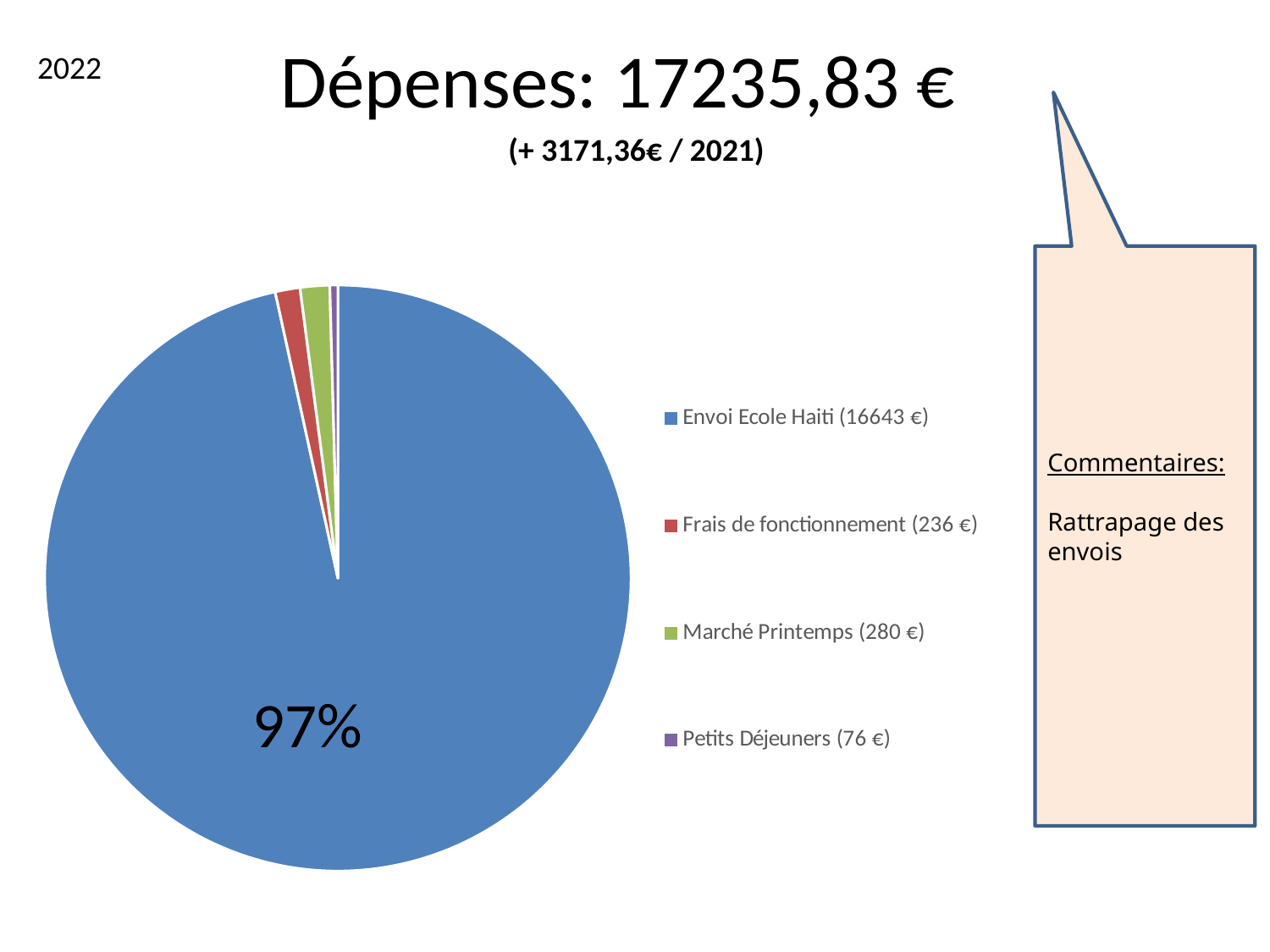
How many categories does the pie chart have? 4 What is the difference between the values for Marché Printemps and Frais de fonctionnement? 44 € Which is larger, Marché Printemps or Frais de fonctionnement? Marché Printemps What kind of chart is shown on the slide? pie chart What is the value shown in the legend for Frais de fonctionnement? 236 € What is the value shown in the legend for Marché Printemps? 280 € What is the value shown in the legend for Envoi Ecole Haiti? 16643 € Which category has the smallest value in the pie chart? Petits Déjeuners Which category has the largest value in the pie chart? Envoi Ecole Haiti What is the value shown in the legend for Petits Déjeuners? 76 € What share of the pie does the Envoi Ecole Haiti slice represent, according to the data label? 97% What is the title of the chart on the slide? Dépenses: 17235,83 €